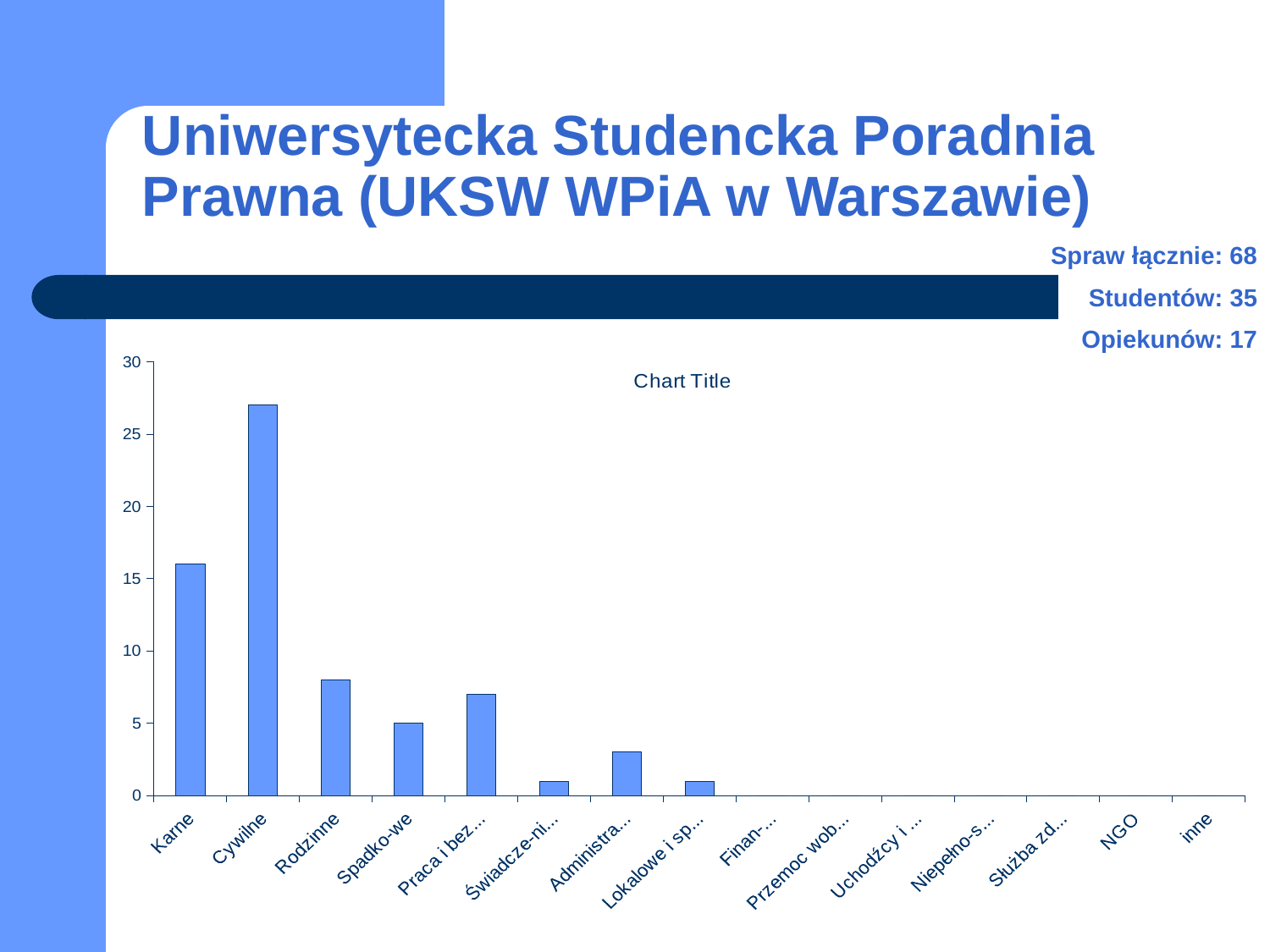
Which category has the highest bar in the chart? Cywilne What is the value for Spadko-we? 5 What is the title shown on the chart? Chart Title Is the value for Cywilne greater or less than 25? greater How many categories are shown on the x axis of the chart? 15 What is the highest value shown on the vertical axis of the chart? 30 Is the value for Karne greater or less than 20? less Which is larger, the value for Karne or the value for Rodzinne? Karne Which is larger, the value for Cywilne or the value for Karne? Cywilne Is the value for Rodzinne greater or less than 10? less What type of chart is shown on the slide? bar chart